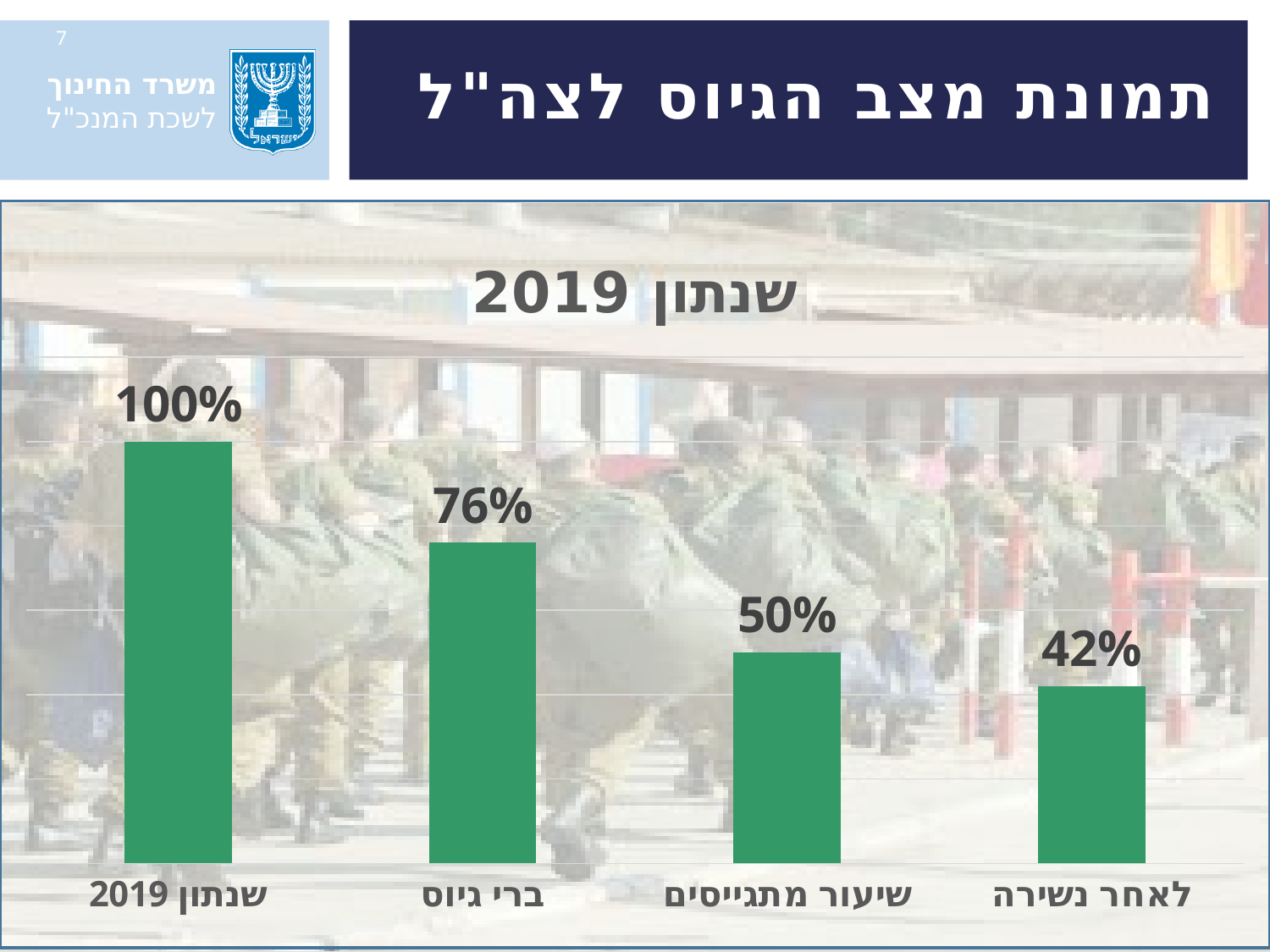
Which is larger, the value for ברי גיוס or the value for לאחר נשירה? ברי גיוס How many categories are shown in the chart? 4 What is the difference between the values for שיעור מתגייסים and לאחר נשירה? 8% What kind of chart is shown on the slide? bar chart What is the title of the chart? שנתון 2019 What is the value for שיעור מתגייסים? 50% Which category has the lowest value? לאחר נשירה What is the value for שנתון 2019? 100% Which category has the highest value? שנתון 2019 What is the difference between the values for ברי גיוס and שיעור מתגייסים? 26% What is the value for ברי גיוס? 76% What is the value for לאחר נשירה? 42%